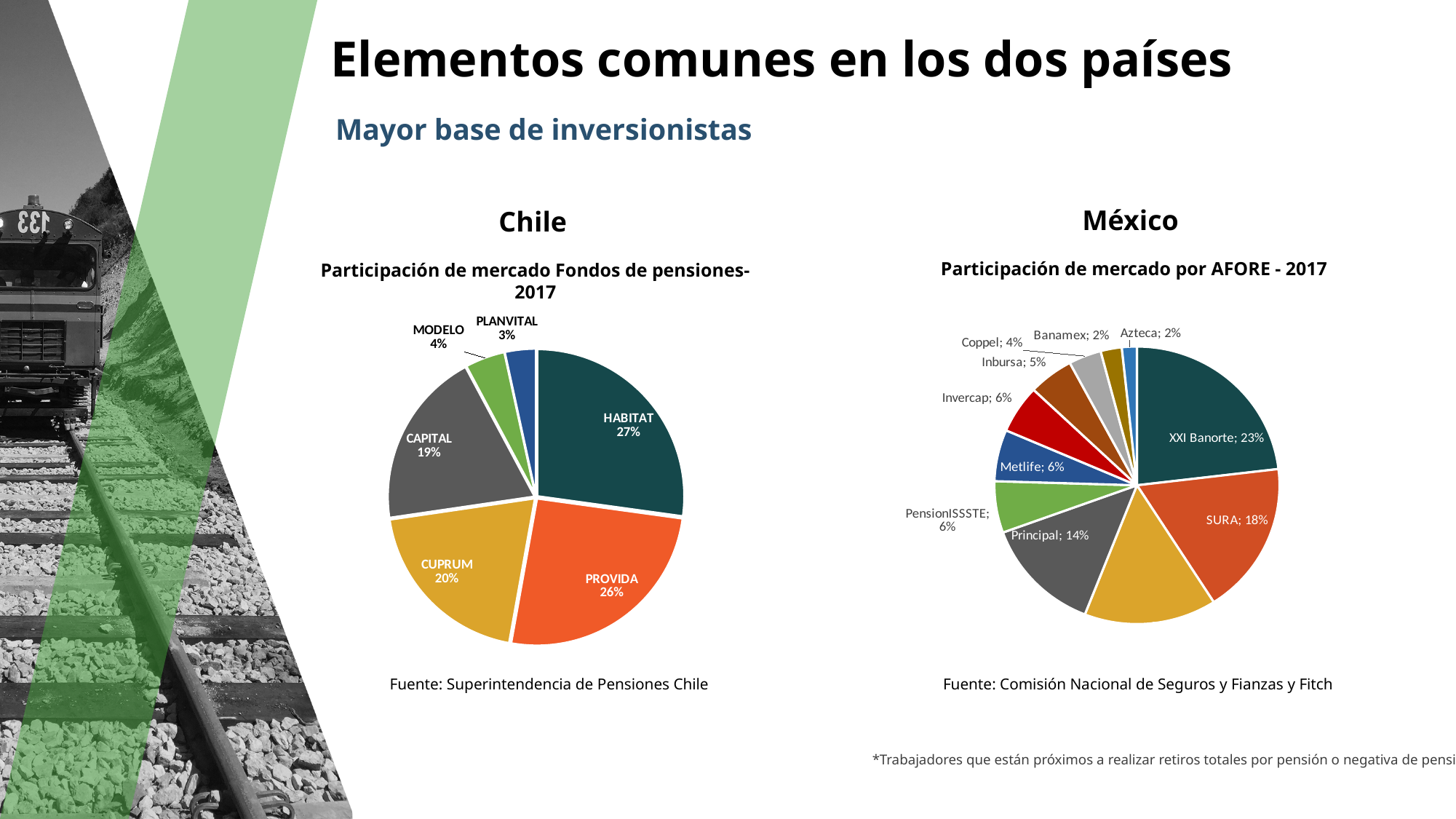
In the Chile chart, how many funds are shown in the pie? 6 In the México chart, what is the difference in market share between XXI Banorte and SURA? 5% In the México chart, what is the market share of SURA? 18% In the Chile chart, what is the market share of HABITAT? 27% In the Chile chart, which fund has the smallest market share? PLANVITAL What type of chart is used for the Chile market share data? Pie chart In the México chart, which AFORE has the largest market share? XXI Banorte In the México chart, which has a larger market share, Inbursa or Coppel? Inbursa In the Chile chart, what is the difference in market share between PROVIDA and CAPITAL? 7% In the Chile chart, which fund has the largest market share? HABITAT In the México chart, what is the market share of Principal? 14% In the Chile chart, what is the market share of CUPRUM? 20%